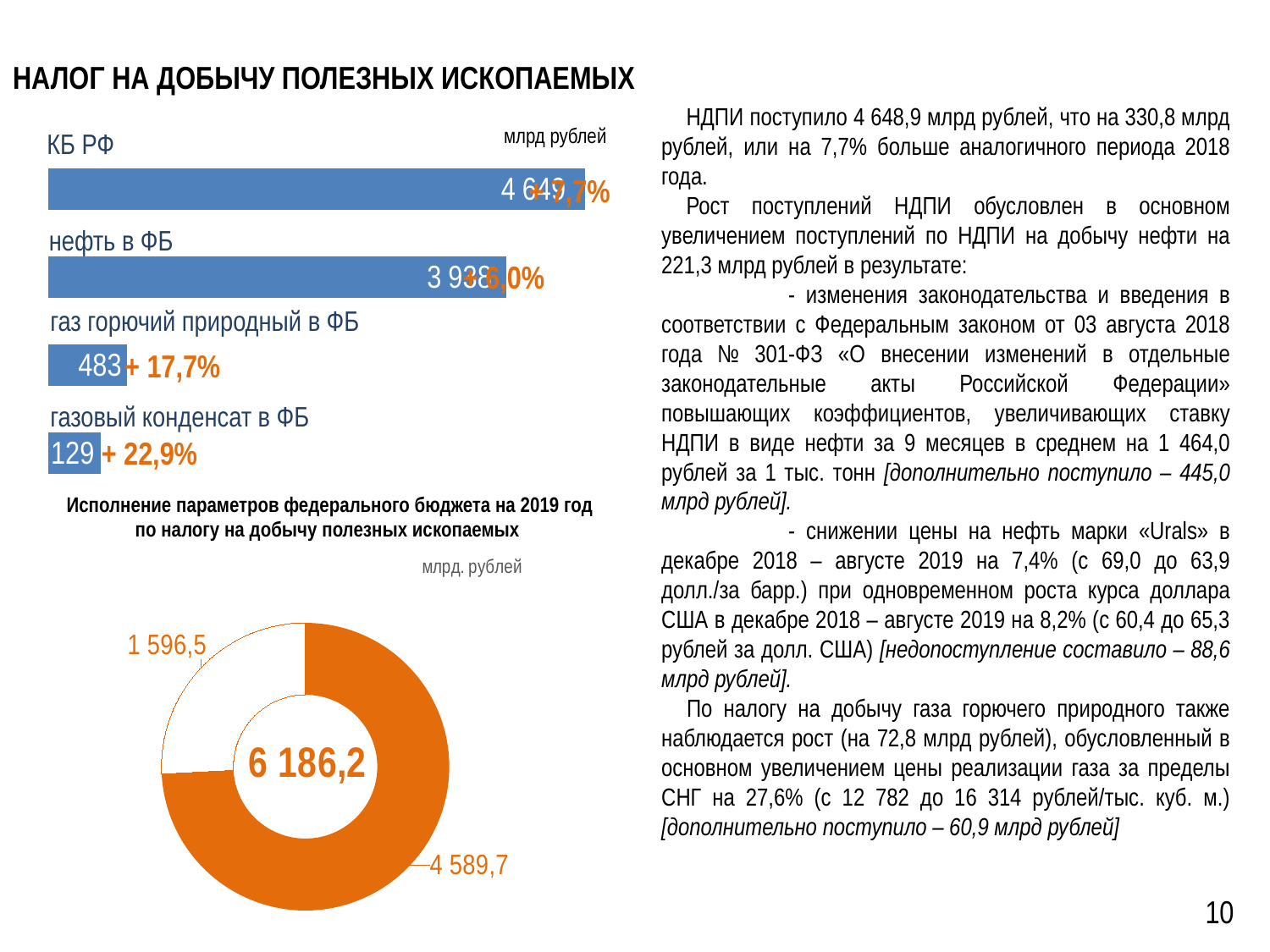
In the bar chart, what is the difference between the values for газ горючий природный в ФБ and газовый конденсат в ФБ? 354 In the doughnut chart 'Исполнение параметров федерального бюджета на 2019 год', what total is shown in the centre? 6 186,2 Which category in the bar chart has the lowest value? газовый конденсат в ФБ In the doughnut chart 'Исполнение параметров федерального бюджета на 2019 год', what value is shown for the orange segment? 4 589,7 In the bar chart, what growth percentage is shown next to газовый конденсат в ФБ? + 22,9% In the bar chart, what growth percentage is shown next to газ горючий природный в ФБ? + 17,7% How many categories does the bar chart at the top left show? 4 In the bar chart, what is the value for газ горючий природный в ФБ? 483 In the bar chart, what is the value for газовый конденсат в ФБ? 129 In the doughnut chart 'Исполнение параметров федерального бюджета на 2019 год', what value is shown for the white segment? 1 596,5 What kind of chart is the chart at the top left of the slide? bar chart In the bar chart, what growth percentage is shown for КБ РФ? +7,7%